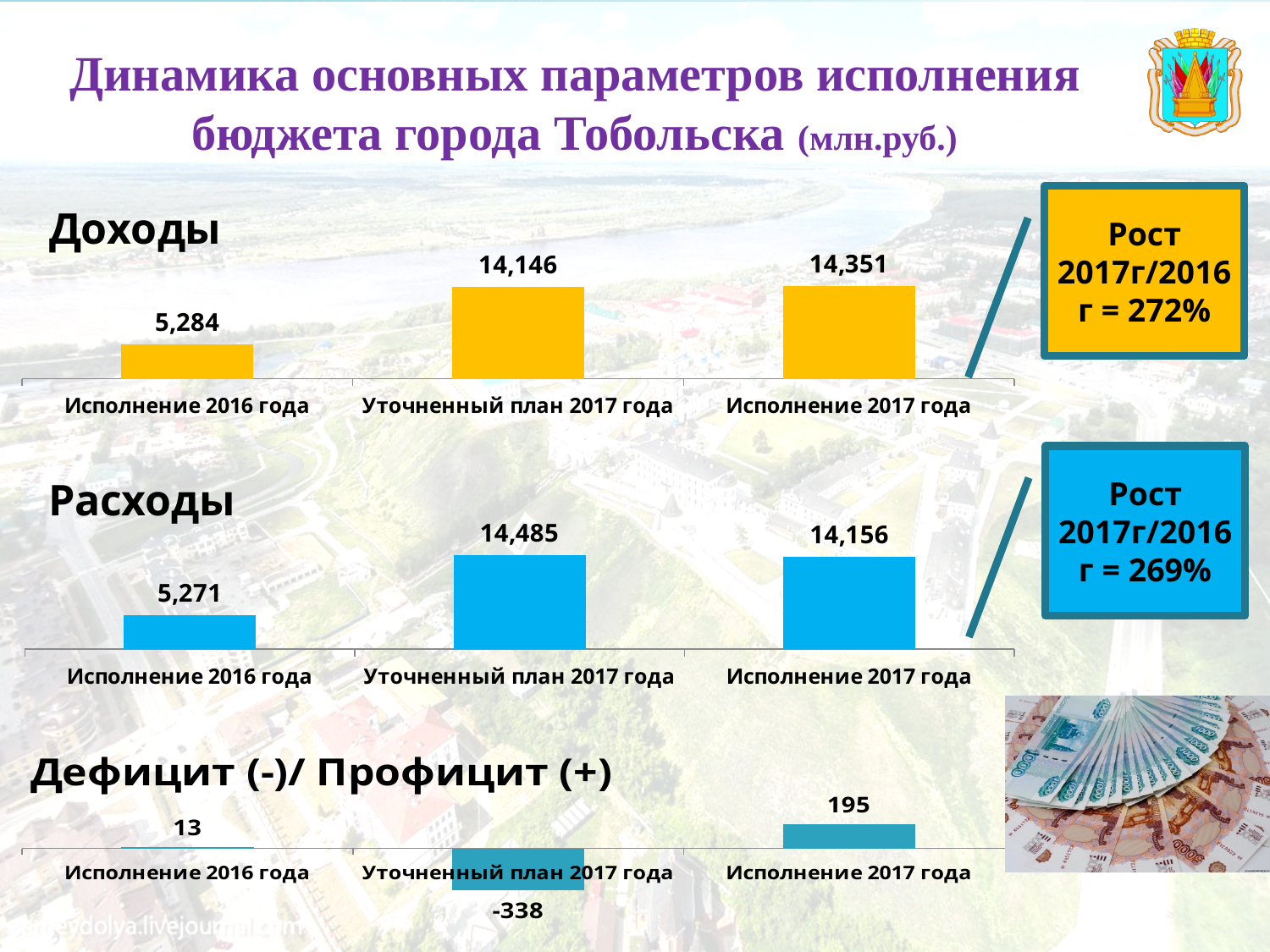
In the Расходы chart, which category has the lowest value? Исполнение 2016 года In the Дефицит (-)/ Профицит (+) chart, what is the value for Уточненный план 2017 года? -338 How many categories are shown in the Дефицит (-)/ Профицит (+) chart? 3 In the Доходы chart, what is the difference between Исполнение 2017 года and Исполнение 2016 года? 9,067 In the Доходы chart, which category has the highest value? Исполнение 2017 года In the Расходы chart, which is larger: Уточненный план 2017 года or Исполнение 2017 года? Уточненный план 2017 года In the Дефицит (-)/ Профицит (+) chart, what is the value for Исполнение 2017 года? 195 In the Доходы chart, what is the value for Исполнение 2017 года? 14,351 In the Расходы chart, what is the difference between Уточненный план 2017 года and Исполнение 2017 года? 329 What type of chart is the Доходы chart? Bar chart In the Расходы chart, what is the value for Уточненный план 2017 года? 14,485 In the Доходы chart, what is the value for Исполнение 2016 года? 5,284